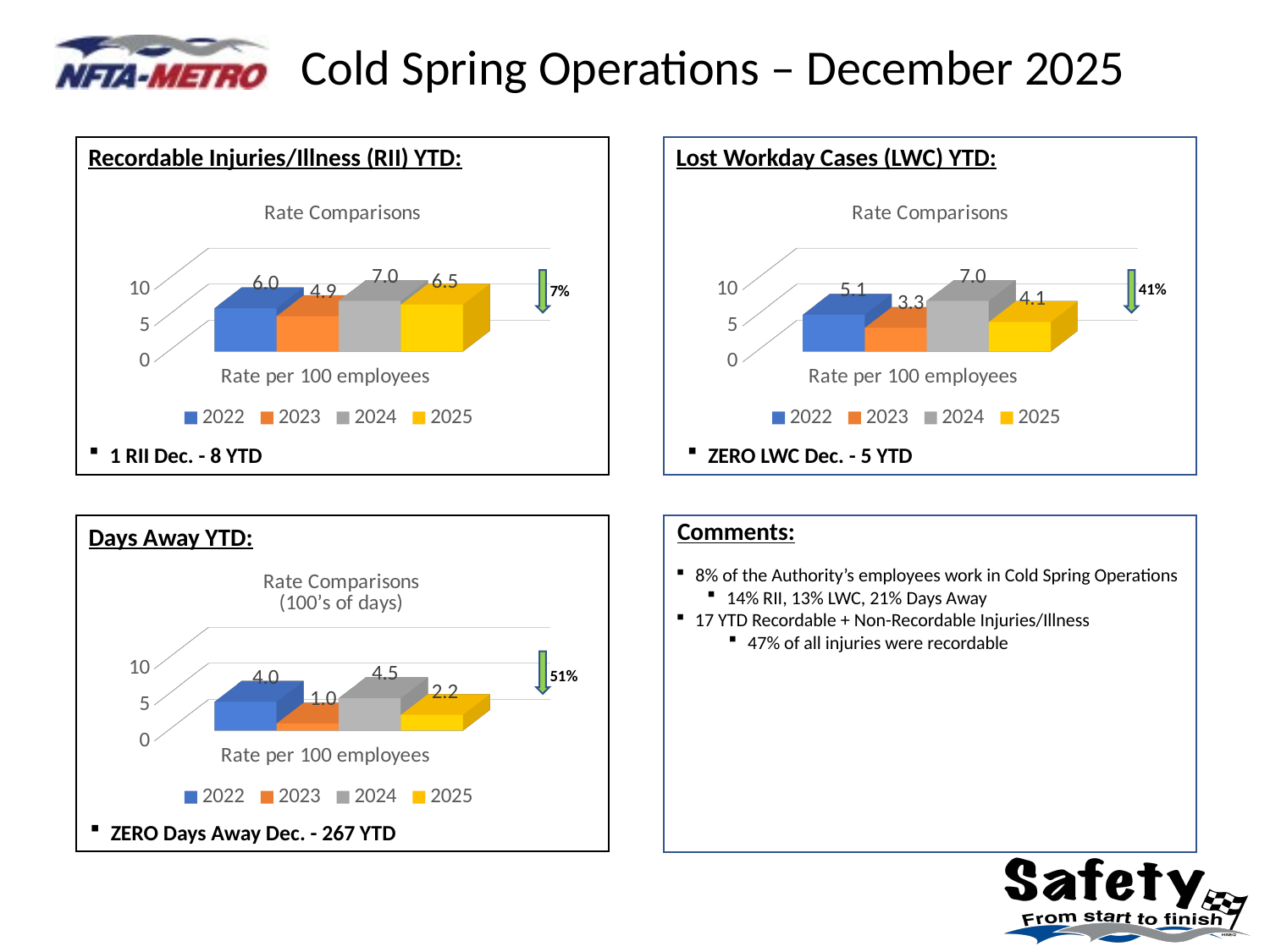
In the Days Away YTD chart, is the value for 2023 greater or less than 5? less In the Recordable Injuries/Illness (RII) YTD chart, what is the value for 2025? 6.5 In the Recordable Injuries/Illness (RII) YTD chart, what colour represents 2024 in the legend? gray In the Lost Workday Cases (LWC) YTD chart, what is the value for 2023? 3.3 In the Days Away YTD chart, what is the difference between the 2022 and 2025 values? 1.8 In the Lost Workday Cases (LWC) YTD chart, which year has the lowest rate? 2023 In the Lost Workday Cases (LWC) YTD chart, which is larger, the value for 2022 or the value for 2025? 2022 How many series does the legend of the Days Away YTD chart list? 4 In the Recordable Injuries/Illness (RII) YTD chart, what is the difference between the 2024 and 2023 values? 2.1 In the Recordable Injuries/Illness (RII) YTD chart, which year has the highest rate? 2024 In the Days Away YTD chart, what is the value for 2024? 4.5 What kind of chart is used in the Lost Workday Cases (LWC) YTD box? bar chart